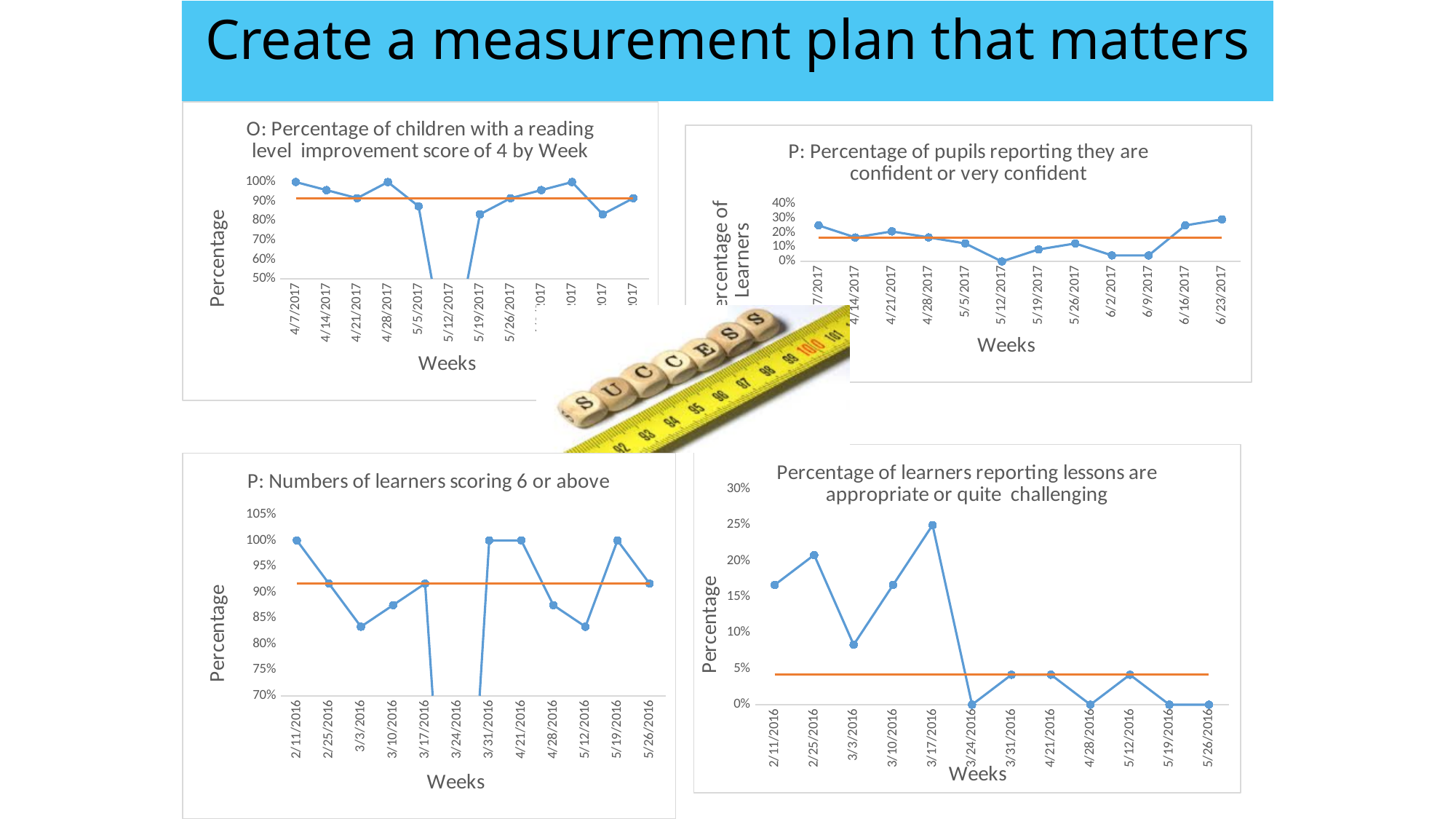
In the chart 'Percentage of learners reporting lessons are appropriate or quite challenging', what is the value for 5/26/2016? 0% In the chart 'P: Numbers of learners scoring 6 or above', what is the value for 2/11/2016? 100% In the chart 'P: Numbers of learners scoring 6 or above', is the value for 3/3/2016 greater or less than 90%? less In the chart 'Percentage of learners reporting lessons are appropriate or quite challenging', which week has the highest value? 3/17/2016 What kind of chart is 'P: Numbers of learners scoring 6 or above'? line chart How many weeks are plotted in the chart 'P: Numbers of learners scoring 6 or above'? 12 In the chart 'O: Percentage of children with a reading level improvement score of 4 by Week', is the value for 5/19/2017 greater or less than 90%? less In the chart 'P: Percentage of pupils reporting they are confident or very confident', which week has the lowest value? 5/12/2017 In the chart 'Percentage of learners reporting lessons are appropriate or quite challenging', what is the value for 3/17/2016? 25% In the chart 'Percentage of learners reporting lessons are appropriate or quite challenging', which is larger, the value for 3/3/2016 or 3/17/2016? 3/17/2016 In the chart 'P: Percentage of pupils reporting they are confident or very confident', is the value for 6/23/2017 greater or less than 20%? greater What is the x-axis title of the chart 'P: Numbers of learners scoring 6 or above'? Weeks